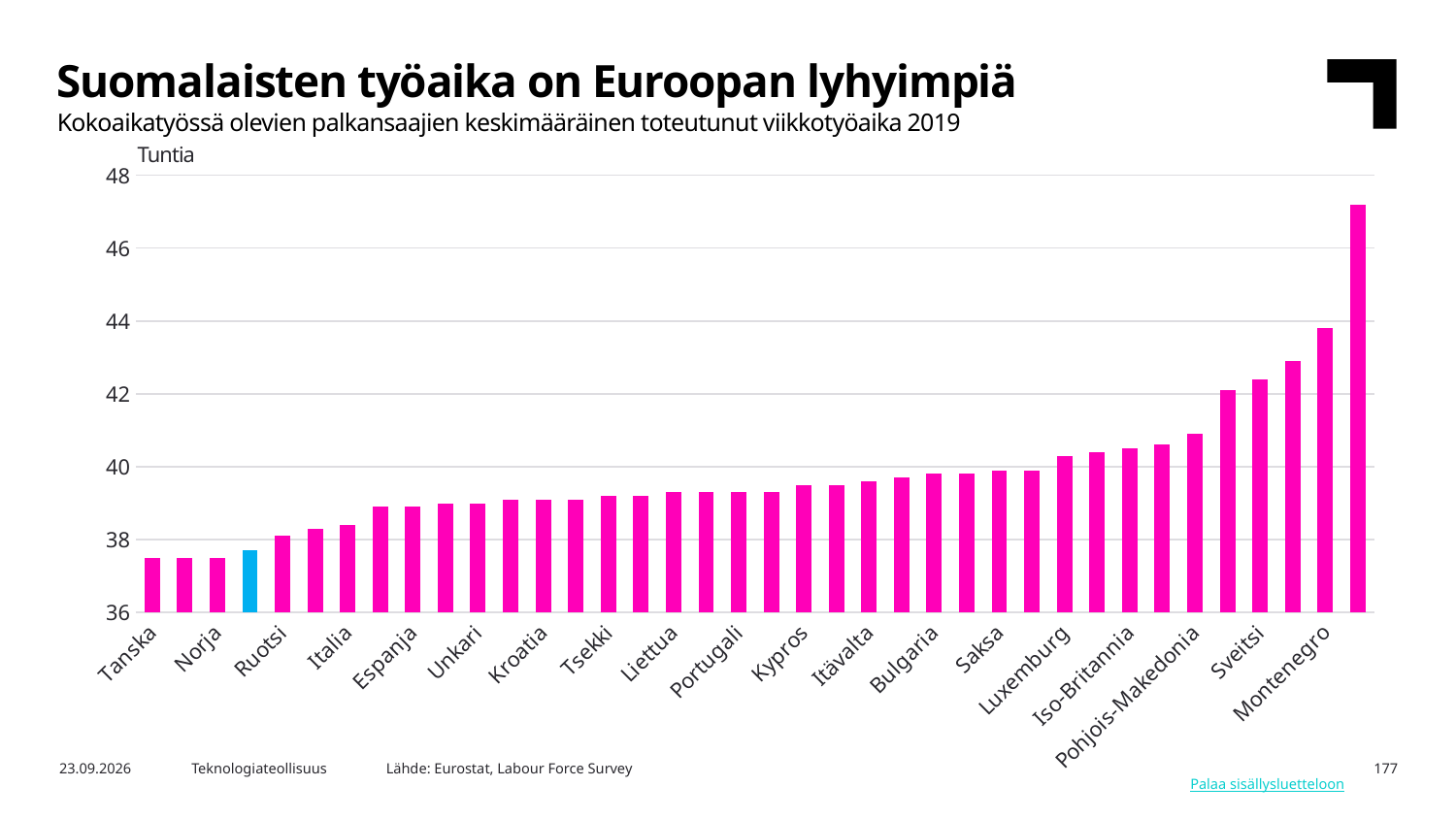
Which has a higher value, Italia or Sveitsi? Sveitsi Is the value for Kroatia greater or less than 40? less Is the value for Pohjois-Makedonia greater or less than 40? greater Is the value for Tanska greater or less than 38? less Which has a higher value, Montenegro or Tanska? Montenegro What unit is shown at the top of the y axis? Tuntia Which has a higher value, Ruotsi or Espanja? Espanja What kind of chart is shown on the slide? bar chart Do the values rise or fall from left to right along the x axis? rise